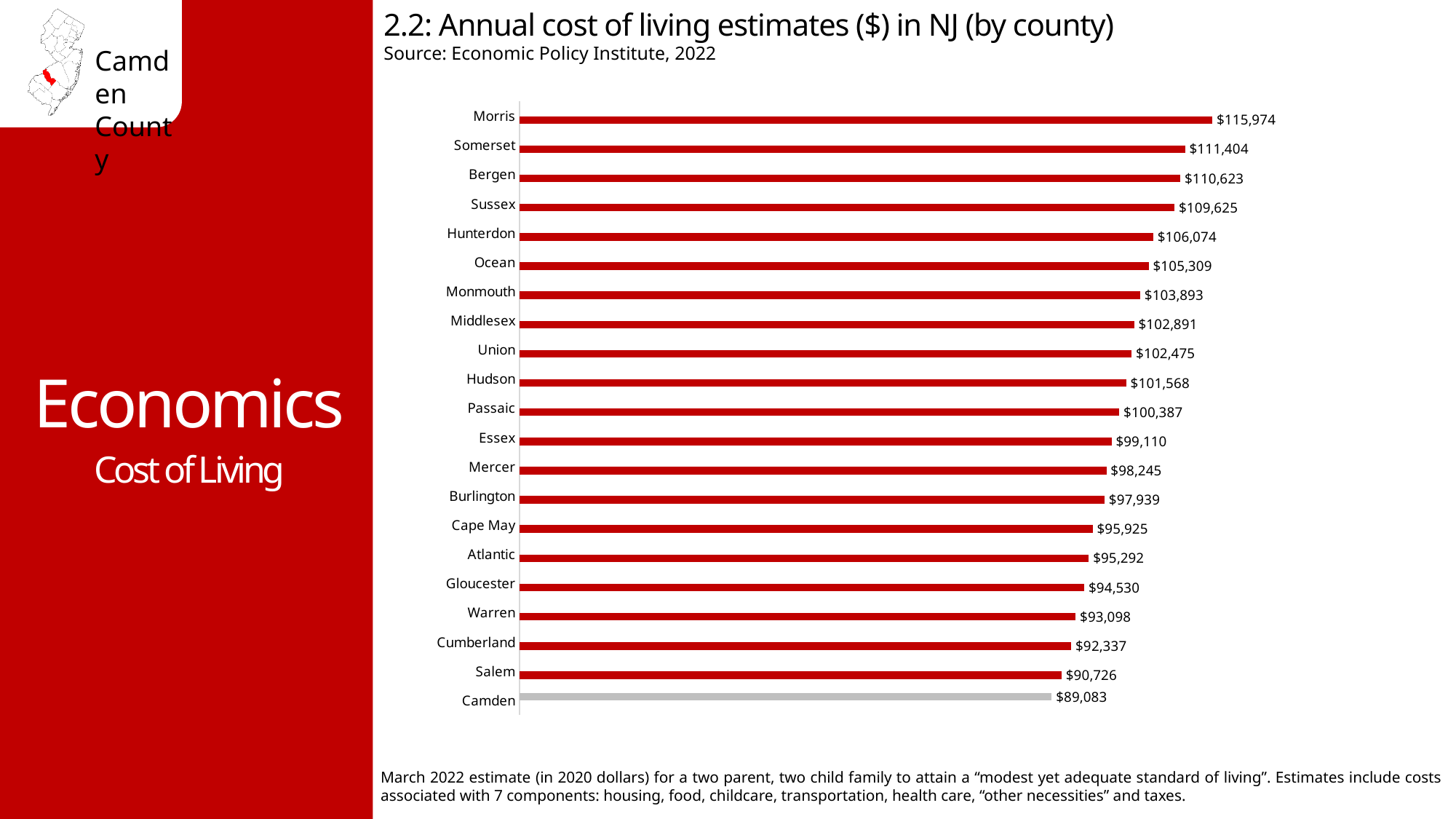
What is the annual cost of living estimate for Middlesex County? $102,891 What type of chart is used on this slide? Bar chart What is the difference between the cost of living estimates for Bergen and Sussex counties? $998 What is the annual cost of living estimate for Morris County? $115,974 Which county has the lowest annual cost of living estimate? Camden What is the source cited for the chart data? Economic Policy Institute, 2022 How many counties are shown in the chart? 21 What is the difference between the cost of living estimates for Morris and Camden counties? $26,891 Which county has a higher cost of living estimate, Hudson or Mercer? Hudson Which county has the highest annual cost of living estimate? Morris What is the annual cost of living estimate for Camden County? $89,083 Which county's bar is shown in a different colour (grey) from the others? Camden